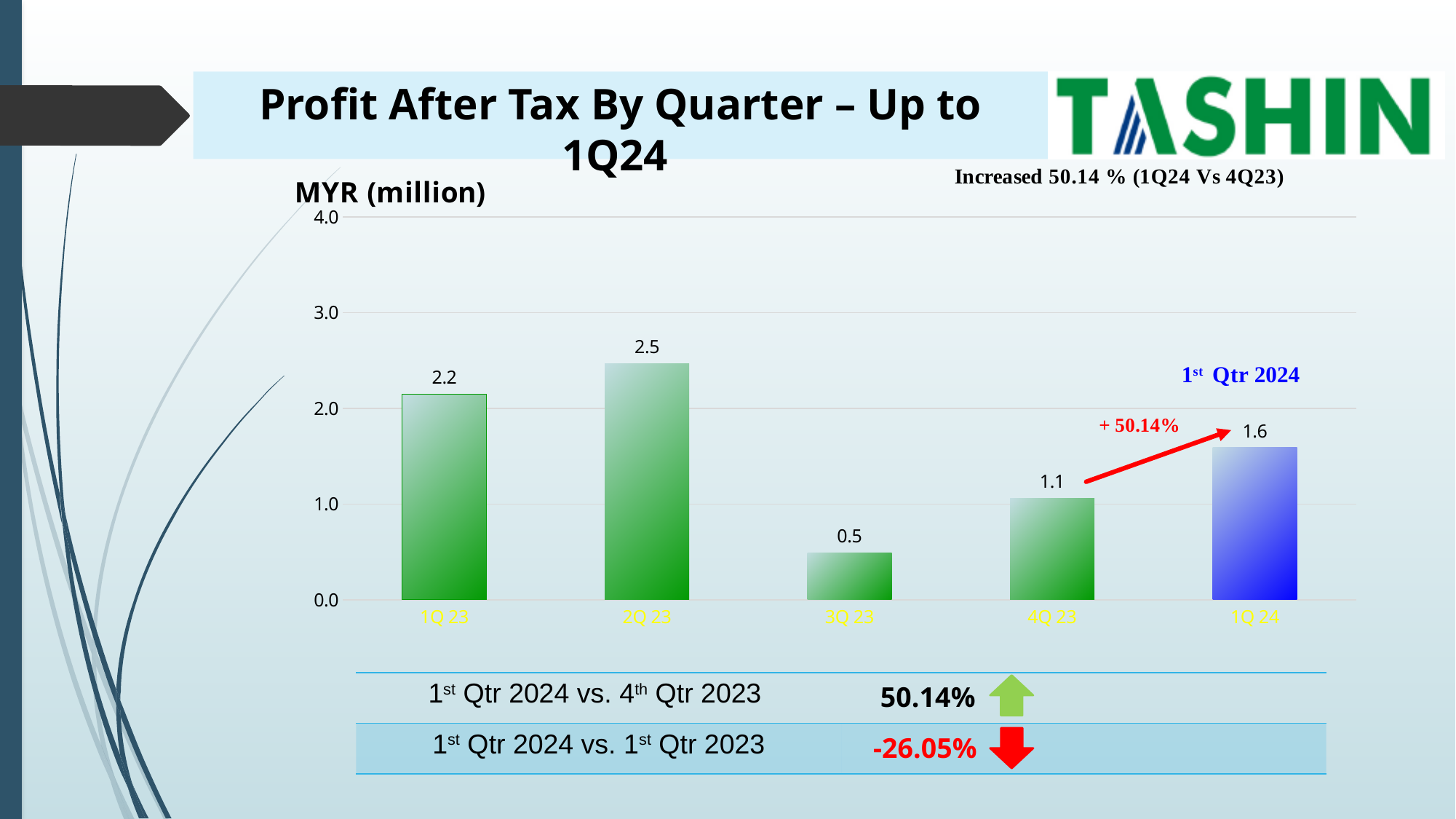
Which quarter has a higher profit after tax, 1Q 23 or 4Q 23? 1Q 23 Which quarter has the highest profit after tax? 2Q 23 What is the difference in profit after tax between 1Q 23 and 1Q 24? 0.6 What kind of chart is shown on the slide? Bar chart Which quarter has the lowest profit after tax? 3Q 23 What is the profit after tax for 1Q 24? 1.6 How many quarters are shown in the chart? 5 What unit is shown on the chart's axis label? MYR (million) What is the profit after tax for 3Q 23? 0.5 Is the value for 2Q 23 greater or less than 2.0? greater What is the difference in profit after tax between 1Q 24 and 4Q 23? 0.5 What is the profit after tax for 2Q 23? 2.5